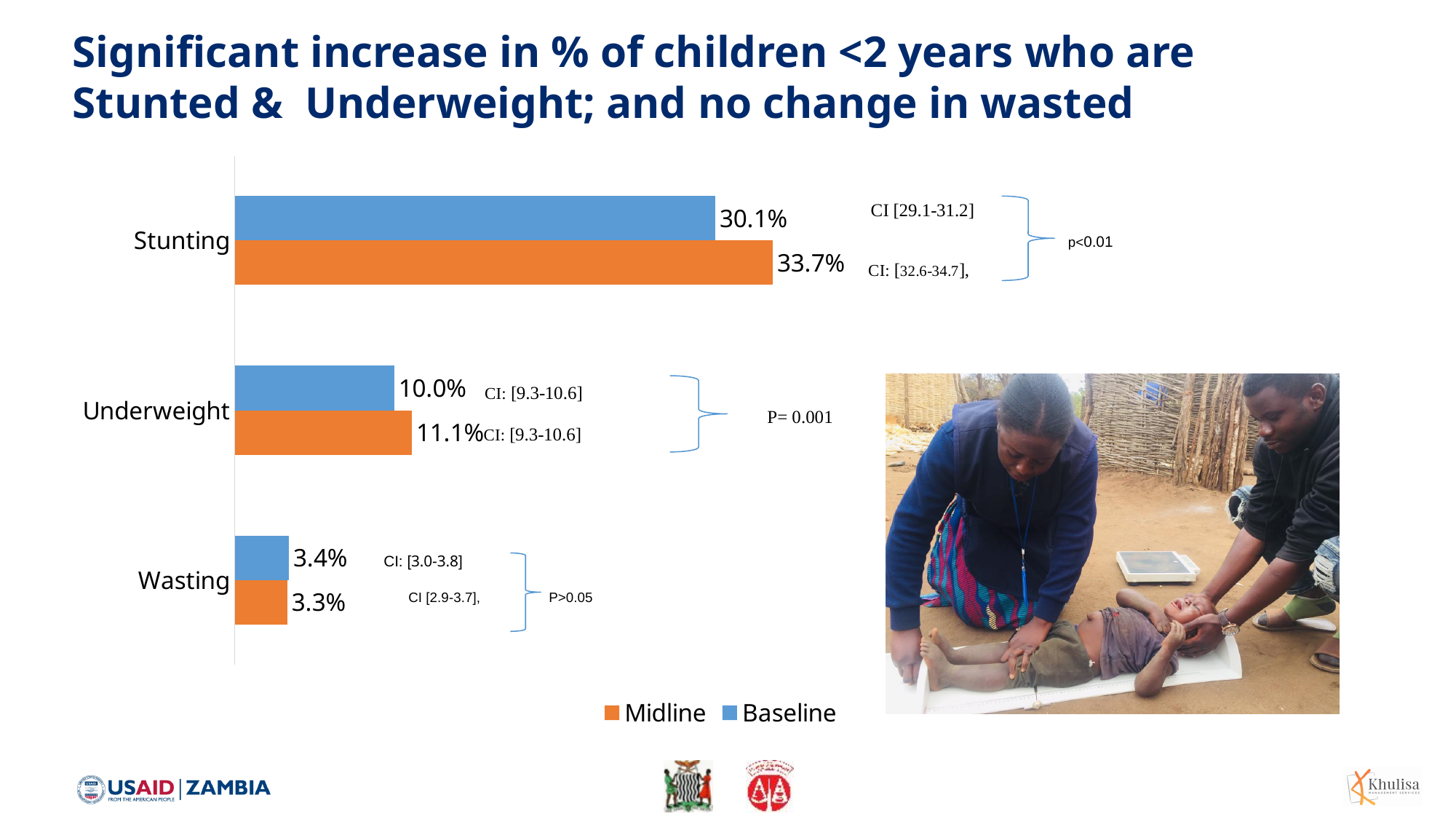
What kind of chart is shown on the slide? Bar chart What is the difference between the Midline and Baseline values for Underweight? 1.1% Which is larger for Underweight, the Midline value or the Baseline value? Midline How many series does the legend list? 2 What is the difference between the Midline and Baseline values for Stunting? 3.6% What is the Midline value for Stunting? 33.7% Which category has the lowest Baseline value? Wasting How many categories are shown on the chart? 3 What is the Baseline value for Stunting? 30.1% What is the Baseline value for Wasting? 3.4% Which category has the highest Midline value? Stunting What is the Midline value for Underweight? 11.1%